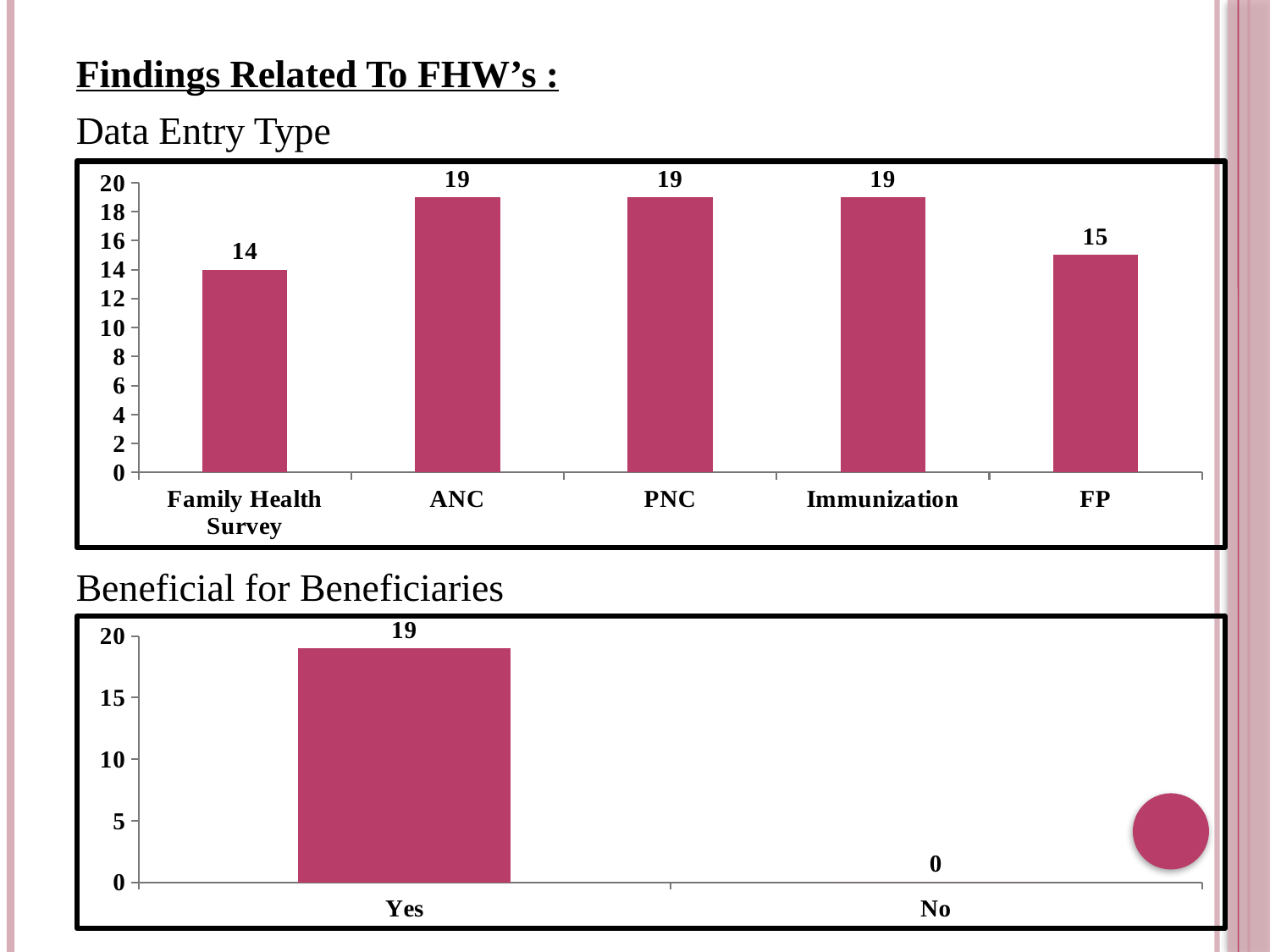
In the Data Entry Type chart, what is the difference between the values for ANC and Family Health Survey? 5 In the Data Entry Type chart, what is the value for Immunization? 19 In the Beneficial for Beneficiaries chart, which category has the highest value? Yes In the Beneficial for Beneficiaries chart, what is the value for Yes? 19 In the Data Entry Type chart, how many categories are shown? 5 In the Data Entry Type chart, what is the value for FP? 15 In the Beneficial for Beneficiaries chart, what is the difference between the values for Yes and No? 19 In the Data Entry Type chart, which is larger, the value for FP or the value for Family Health Survey? FP In the Data Entry Type chart, what is the value for Family Health Survey? 14 What kind of chart is the Data Entry Type chart? Bar chart In the Data Entry Type chart, which category has the lowest value? Family Health Survey In the Beneficial for Beneficiaries chart, what is the value for No? 0